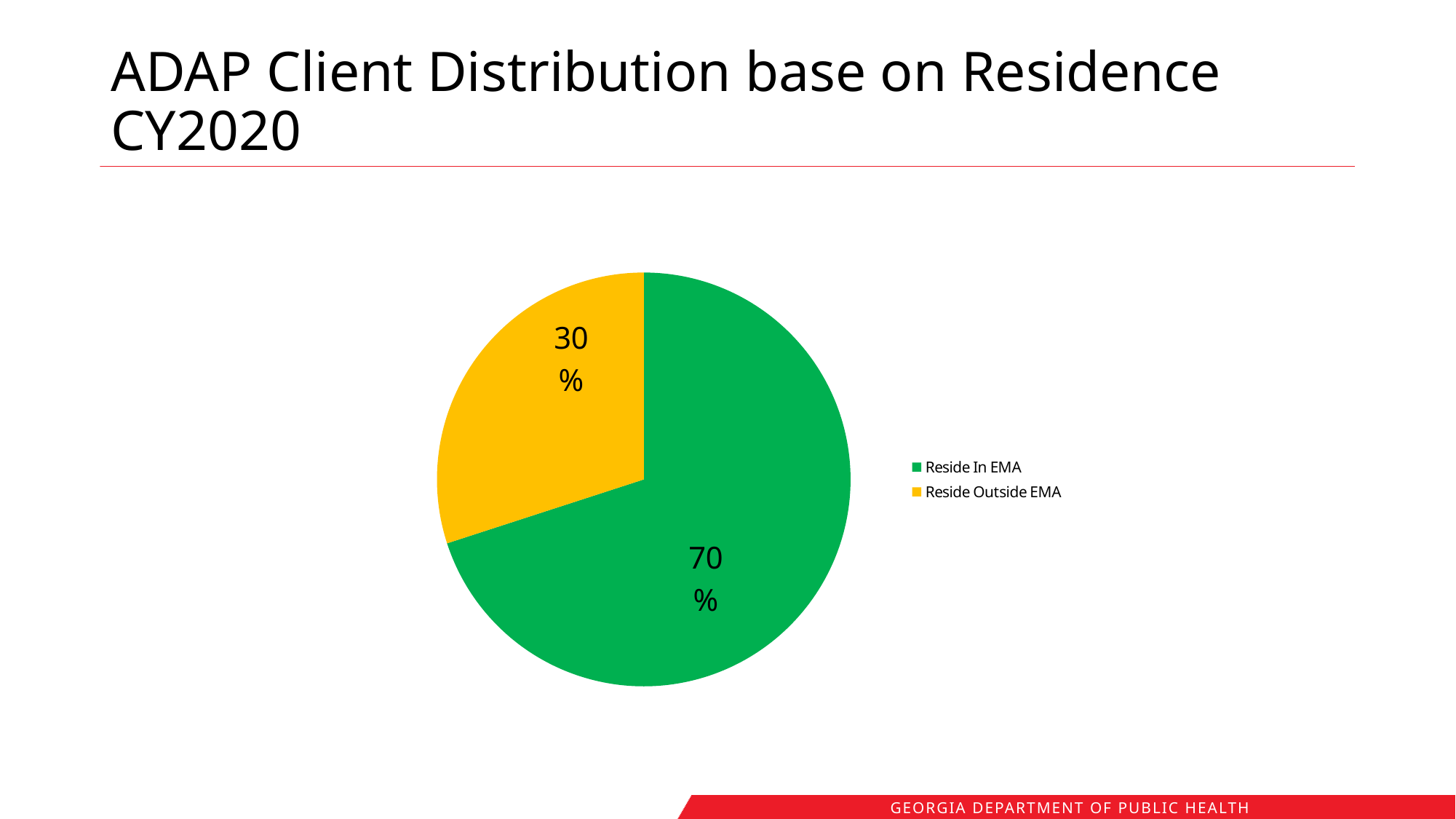
What kind of chart is shown on the slide? pie chart What share of the pie does the Reside Outside EMA slice represent? 30% What is the title of the slide containing the chart? ADAP Client Distribution base on Residence CY2020 Which category has the smallest share of the pie? Reside Outside EMA What percentage of ADAP clients reside in the EMA? 70% What is the difference in percentage points between Reside In EMA and Reside Outside EMA? 40 How many entries does the legend list? 2 Which category has the largest share of the pie? Reside In EMA Which is larger, the share for Reside In EMA or Reside Outside EMA? Reside In EMA How many slices does the pie chart have? 2 What percentage of ADAP clients reside outside the EMA? 30% What colour is the Reside In EMA slice? green